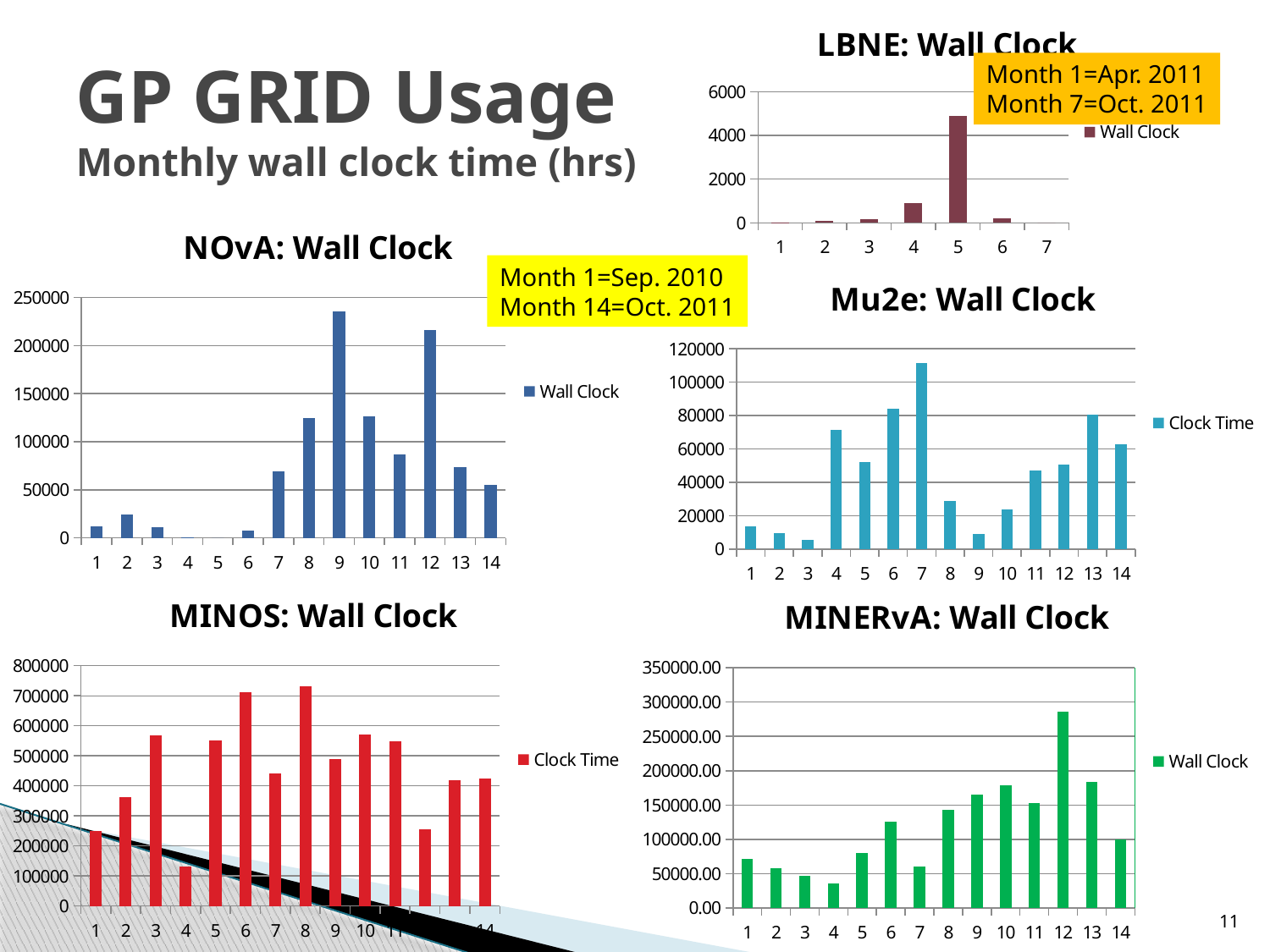
How many months are shown on the x axis of the LBNE: Wall Clock chart? 7 On the NOvA: Wall Clock chart, is the value for month 9 greater or less than 200000? greater What kind of chart is the Mu2e: Wall Clock chart? bar chart On the LBNE: Wall Clock chart, which month has the highest value? 5 On the MINERvA: Wall Clock chart, which month has the highest value? 12 On the LBNE: Wall Clock chart, is the value for month 5 greater or less than 4000? greater On the MINOS: Wall Clock chart, is the value for month 4 greater or less than 200000? less On the Mu2e: Wall Clock chart, which month has the lowest value? 3 On the MINERvA: Wall Clock chart, which is larger, the value for month 10 or month 11? month 10 On the NOvA: Wall Clock chart, which month has the highest value? 9 On the NOvA: Wall Clock chart, which is larger, the value for month 7 or month 11? month 11